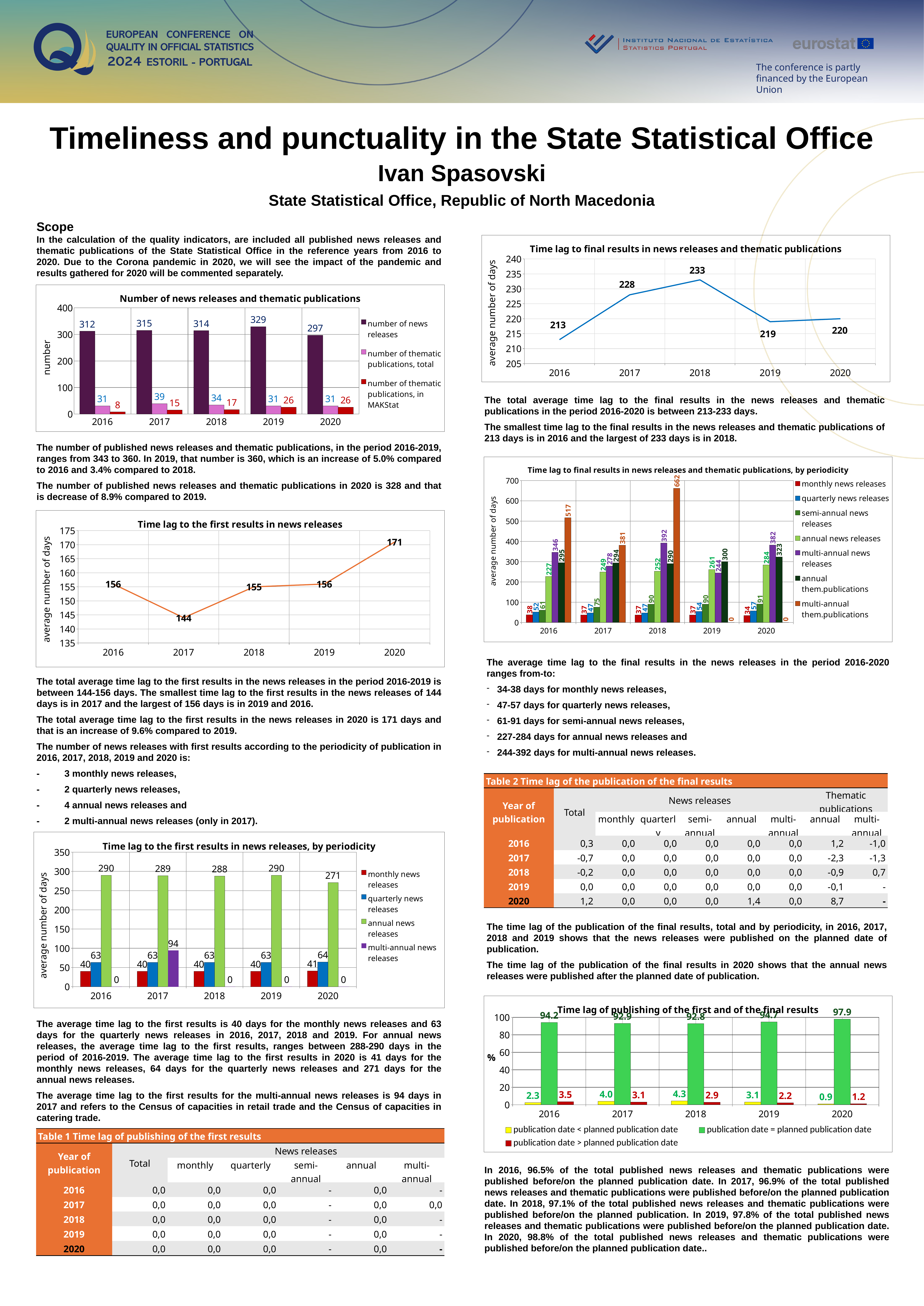
In the chart 'Number of news releases and thematic publications', what is the number of news releases in 2019? 329 In the chart 'Time lag to the first results in news releases', what is the value for 2017? 144 In the chart 'Time lag to the first results in news releases', what is the difference between the values for 2020 and 2019? 15 In the chart 'Number of news releases and thematic publications', which year has the lowest number of news releases? 2020 In the chart 'Number of news releases and thematic publications', how many series does the legend list? 3 What kind of chart is 'Time lag to the first results in news releases'? line chart In the chart 'Time lag to the first results in news releases, by periodicity', what is the value for annual news releases in 2020? 271 In the chart 'Time lag of publishing of the first and of the final results', which is larger: the value for 'publication date = planned publication date' in 2020 or in 2018? 2020 In the chart 'Time lag to final results in news releases and thematic publications', which year has the highest value? 2018 In the chart 'Time lag to final results in news releases and thematic publications, by periodicity', is the value for multi-annual news releases in 2016 greater or less than 300? greater In the chart 'Time lag to final results in news releases and thematic publications', how many years are plotted? 5 In the chart 'Time lag to final results in news releases and thematic publications, by periodicity', what is the value for multi-annual them.publications in 2018? 662